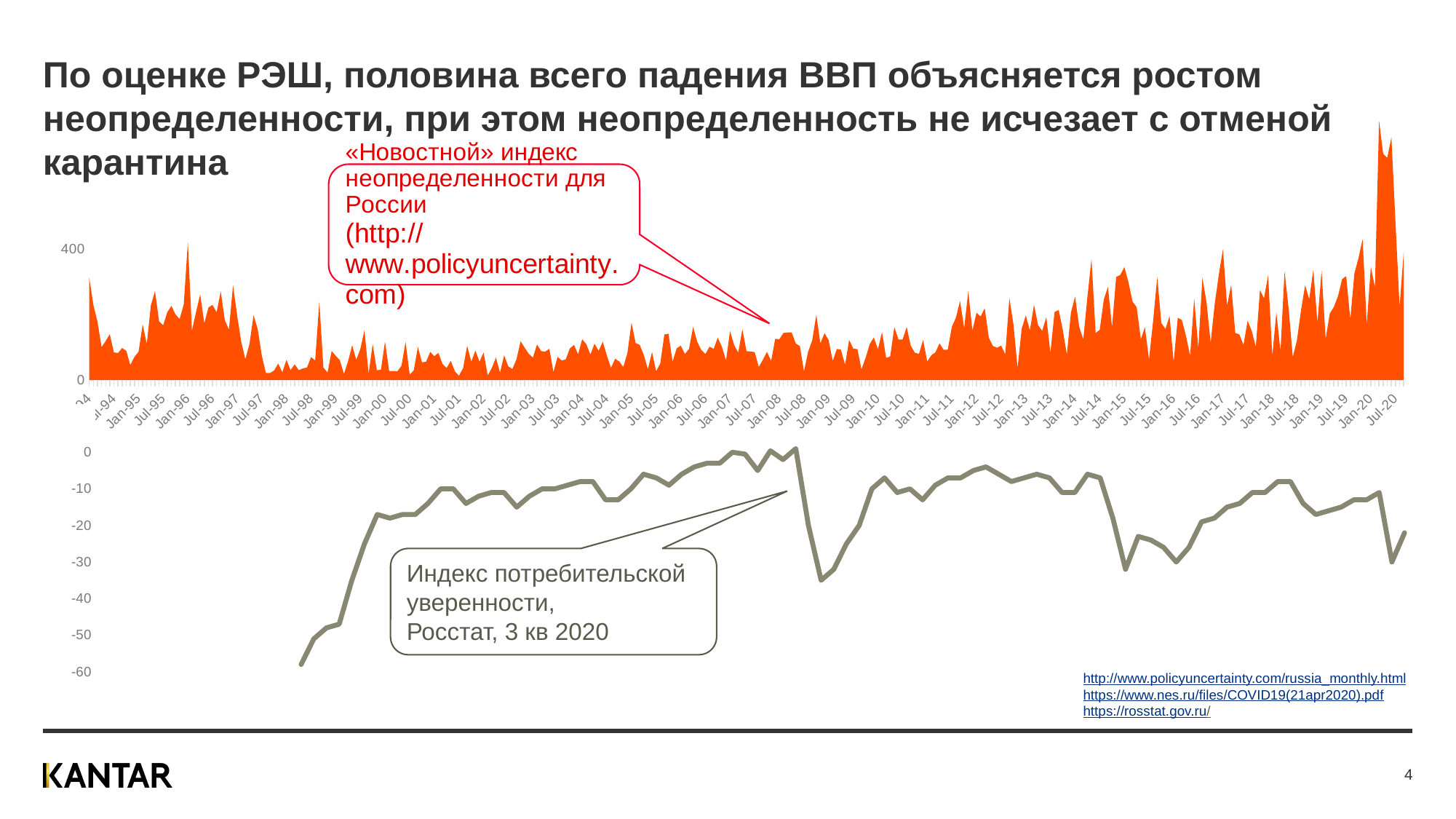
In the bottom chart (consumer confidence index), is the lowest value at the start of the series greater or less than -50? less What kind of chart is the bottom chart on the slide (the grey one)? Line chart According to the callout on the bottom chart, what index does it show and from which source? Индекс потребительской уверенности, Росстат, 3 кв 2020 In the top chart (news uncertainty index for Russia), is the peak in 2020 higher or lower than the peak in 1996? higher In the bottom chart (consumer confidence index), is the value at the dip around 2009 greater or less than -20? less In the top chart (news uncertainty index for Russia), in which year does the series reach its highest peak? 2020 In the bottom chart (consumer confidence index), does the series rise or fall from its first point up to around 2008? rise In the bottom chart (consumer confidence index), is the value around 2008 higher or lower than the value around 2009? higher What kind of chart is the top chart on the slide (the orange one)? Area chart What is the highest tick value shown on the y axis of the top chart? 400 In the top chart (news uncertainty index for Russia), is the highest peak in 2020 greater or less than 400? greater